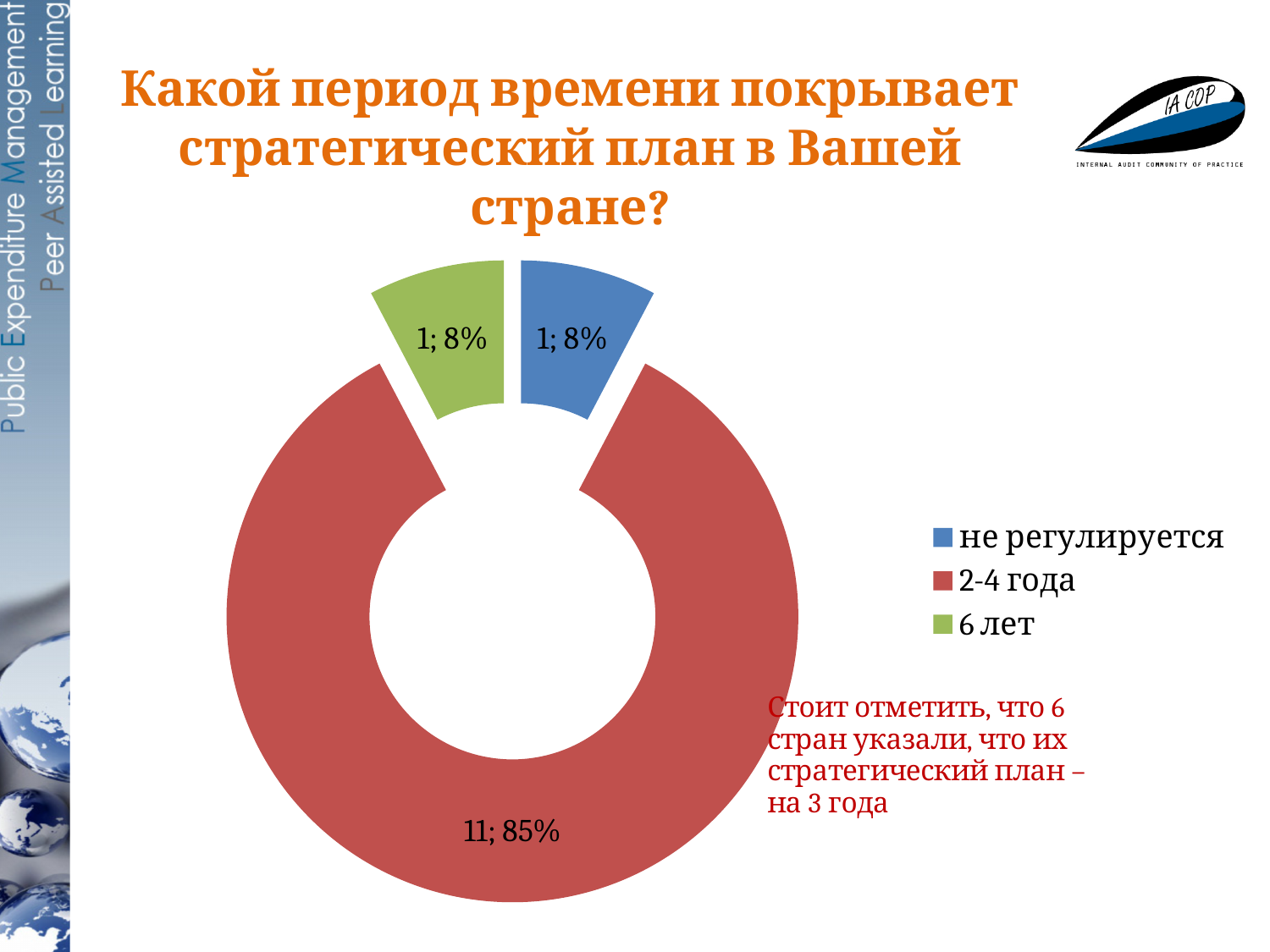
What is the count shown for the category "2-4 года"? 11 How many entries does the legend list? 3 How many categories does the chart show? 3 What percentage share is shown for "6 лет"? 8% What is the count shown for "не регулируется"? 1 What is the total count across all three categories? 13 What kind of chart is shown on the slide? doughnut chart What colour represents "6 лет" in the chart? green What is the difference between the count for "2-4 года" and the count for "не регулируется"? 10 What percentage share is shown for "2-4 года"? 85% Which is larger, the value for "2-4 года" or the value for "6 лет"? 2-4 года Which category has the largest share of the chart? 2-4 года